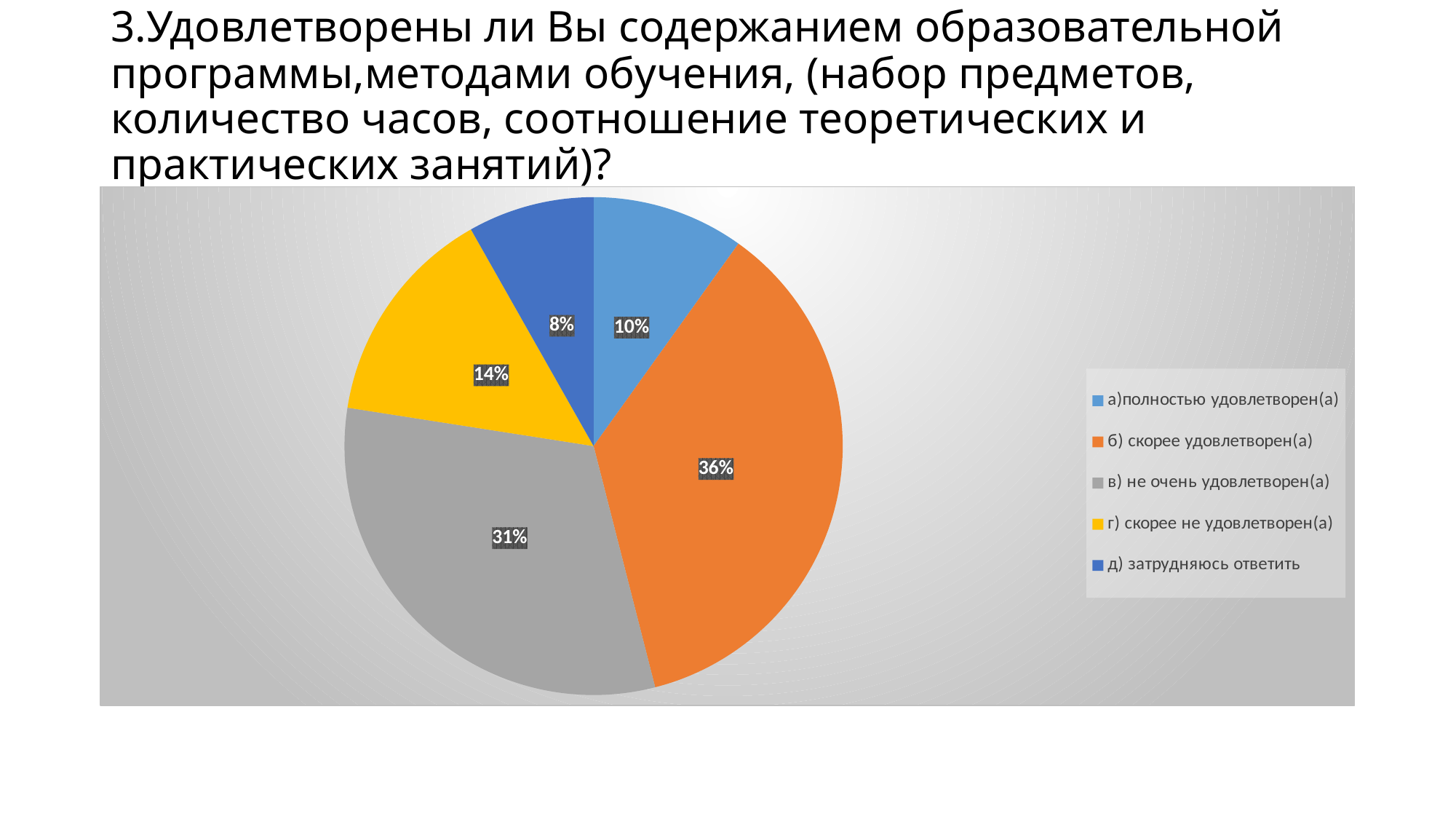
Which is larger: the slice for "г) скорее не удовлетворен(а)" or the slice for "а)полностью удовлетворен(а)"? г) скорее не удовлетворен(а) What share of the pie is labelled for "д) затрудняюсь ответить"? 8% What share of the pie is labelled for "в) не очень удовлетворен(а)"? 31% What share of the pie is labelled for "г) скорее не удовлетворен(а)"? 14% What share of the pie is labelled for "б) скорее удовлетворен(а)"? 36% Which category has the largest slice of the pie? б) скорее удовлетворен(а) Which category has the smallest slice of the pie? д) затрудняюсь ответить What colour is the slice for "г) скорее не удовлетворен(а)"? yellow What share of the pie is labelled for "а)полностью удовлетворен(а)"? 10% What is the difference in percentage points between "б) скорее удовлетворен(а)" and "в) не очень удовлетворен(а)"? 5 How many categories does the legend list? 5 What kind of chart is shown on the slide? pie chart